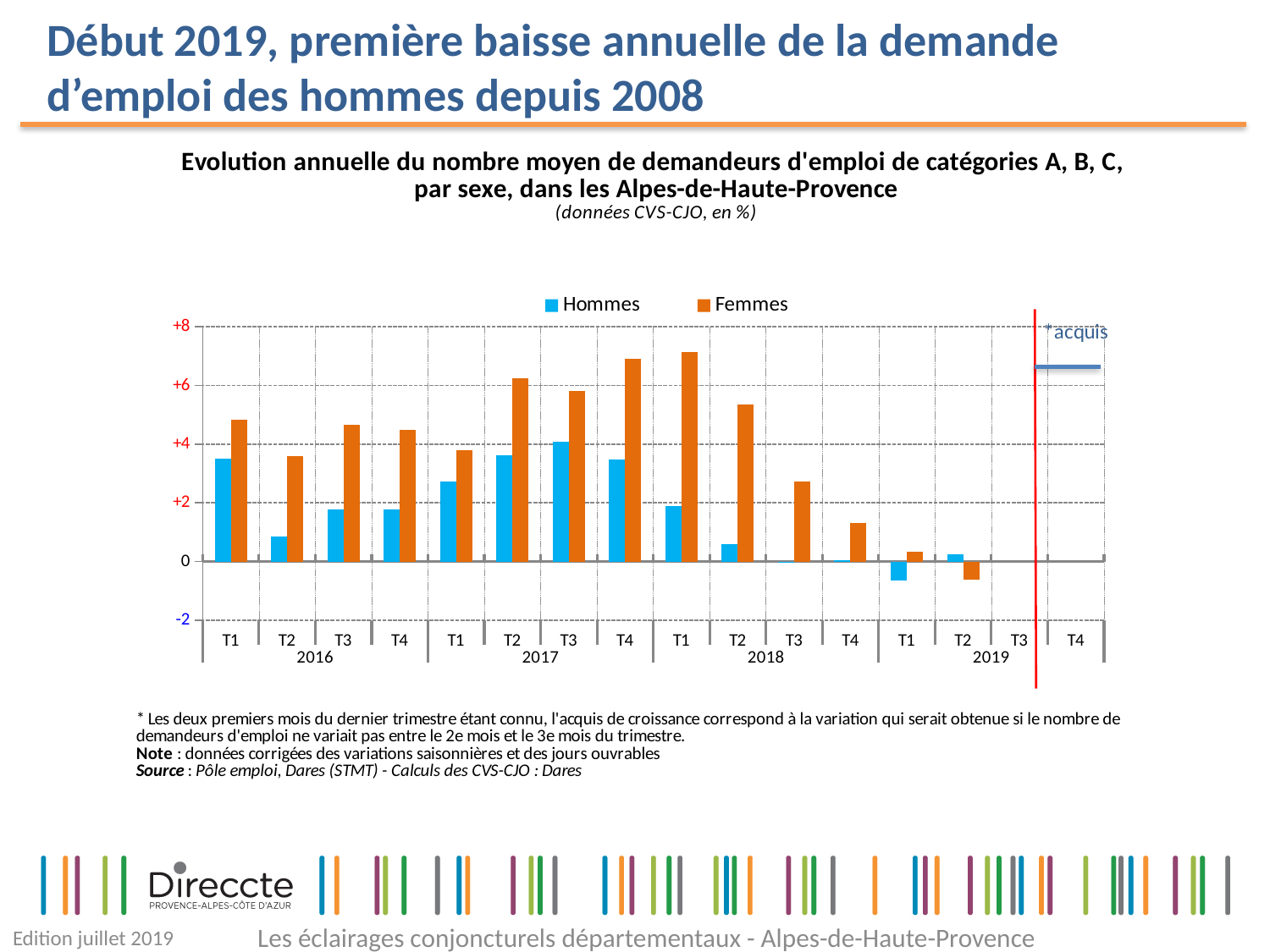
In which quarter is the Hommes value the lowest? T1 2019 In T1 2016, which series has the larger value, Hommes or Femmes? Femmes In which quarter is the Femmes value the lowest? T2 2019 What are the two series named in the legend? Hommes and Femmes Is the value for Femmes in T4 2017 greater or less than +6? greater Which colour represents the Femmes series? orange What kind of chart is shown on the slide? bar chart Do the Femmes values rise or fall from T1 2018 to T2 2019? fall How many series does the legend list? 2 Is the value for Hommes in T2 2016 greater or less than +2? less Is the value for Femmes in T3 2018 greater or less than +2? greater